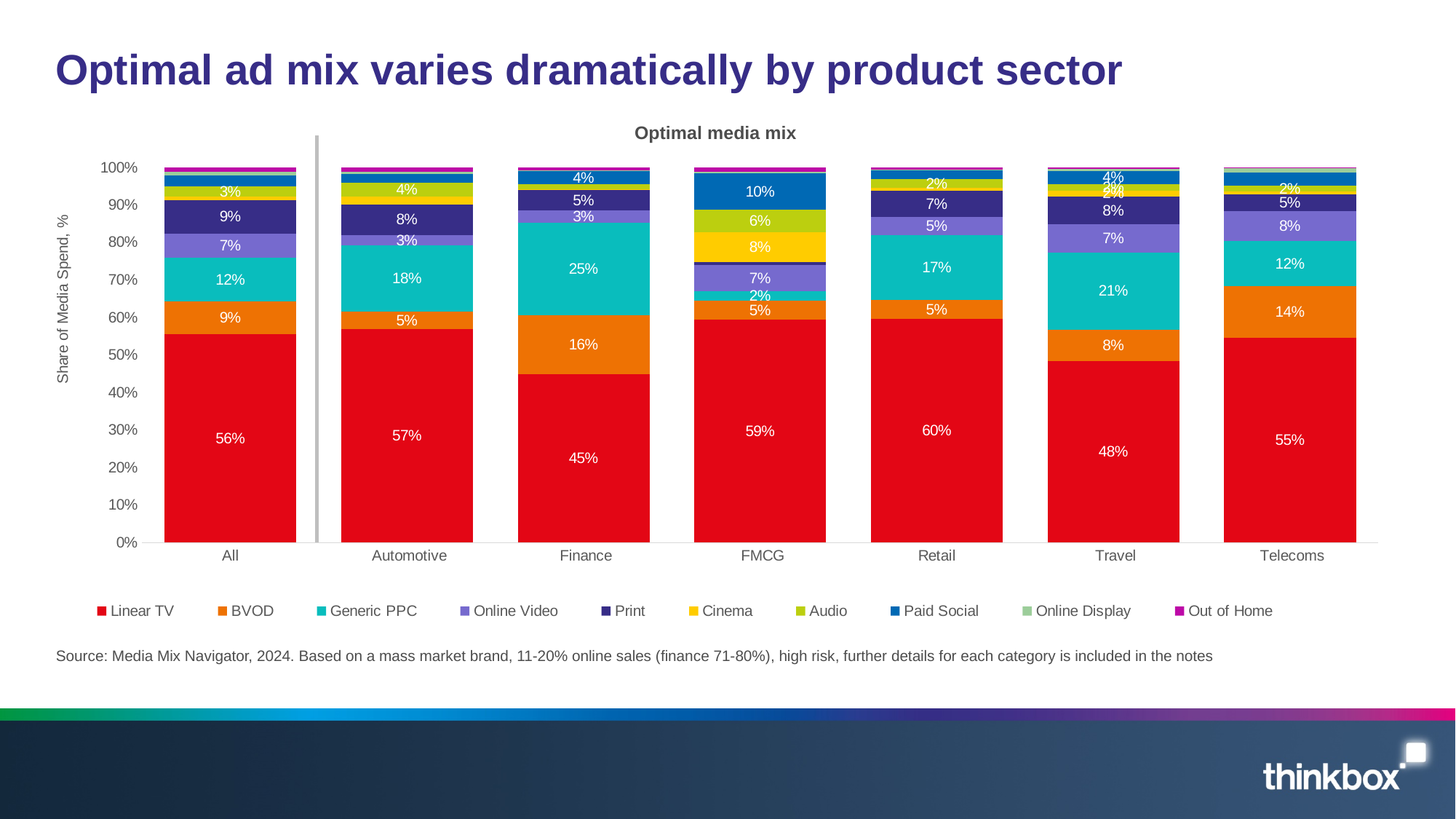
Which has a larger BVOD share, Finance or Automotive? Finance What kind of chart is shown on the slide? Stacked bar chart What is the Generic PPC share for the Travel sector? 21% What is the Linear TV share of media spend for the Finance sector? 45% How many sectors (categories) are shown on the x axis? 7 What is the Paid Social share for FMCG? 10% Which sector has the lowest Linear TV share? Finance Which sector has the highest Linear TV share? Retail How many percentage points higher is the Generic PPC share for Finance than for All? 13 percentage points How many series does the legend list? 10 What is the BVOD share for Telecoms? 14%